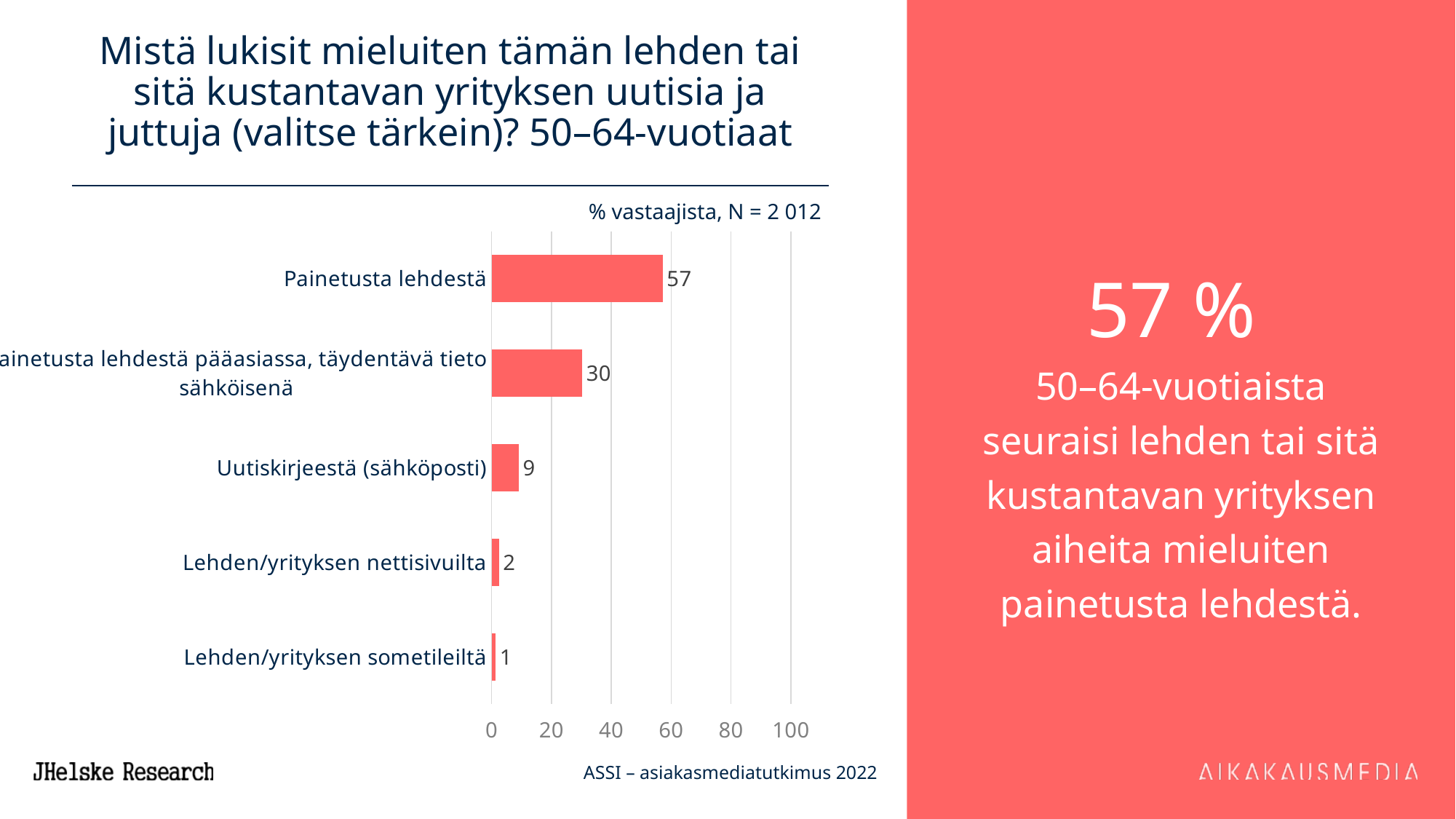
What is the sample size (N) stated above the chart? 2 012 What kind of chart is shown on the slide? bar chart What is the value for "Painetusta lehdestä"? 57 Is the value for "Painetusta lehdestä" greater or less than 40? greater What is the value for "Lehden/yrityksen sometileiltä"? 1 Which category has the lowest value? Lehden/yrityksen sometileiltä How many categories are shown in the chart? 5 What is the difference between the values for "Painetusta lehdestä" and "Uutiskirjeestä (sähköposti)"? 48 Which is larger: the value for "Uutiskirjeestä (sähköposti)" or the value for "Lehden/yrityksen nettisivuilta"? Uutiskirjeestä (sähköposti) What is the value for "Lehden/yrityksen nettisivuilta"? 2 Which category has the highest value? Painetusta lehdestä What is the value for "Uutiskirjeestä (sähköposti)"? 9